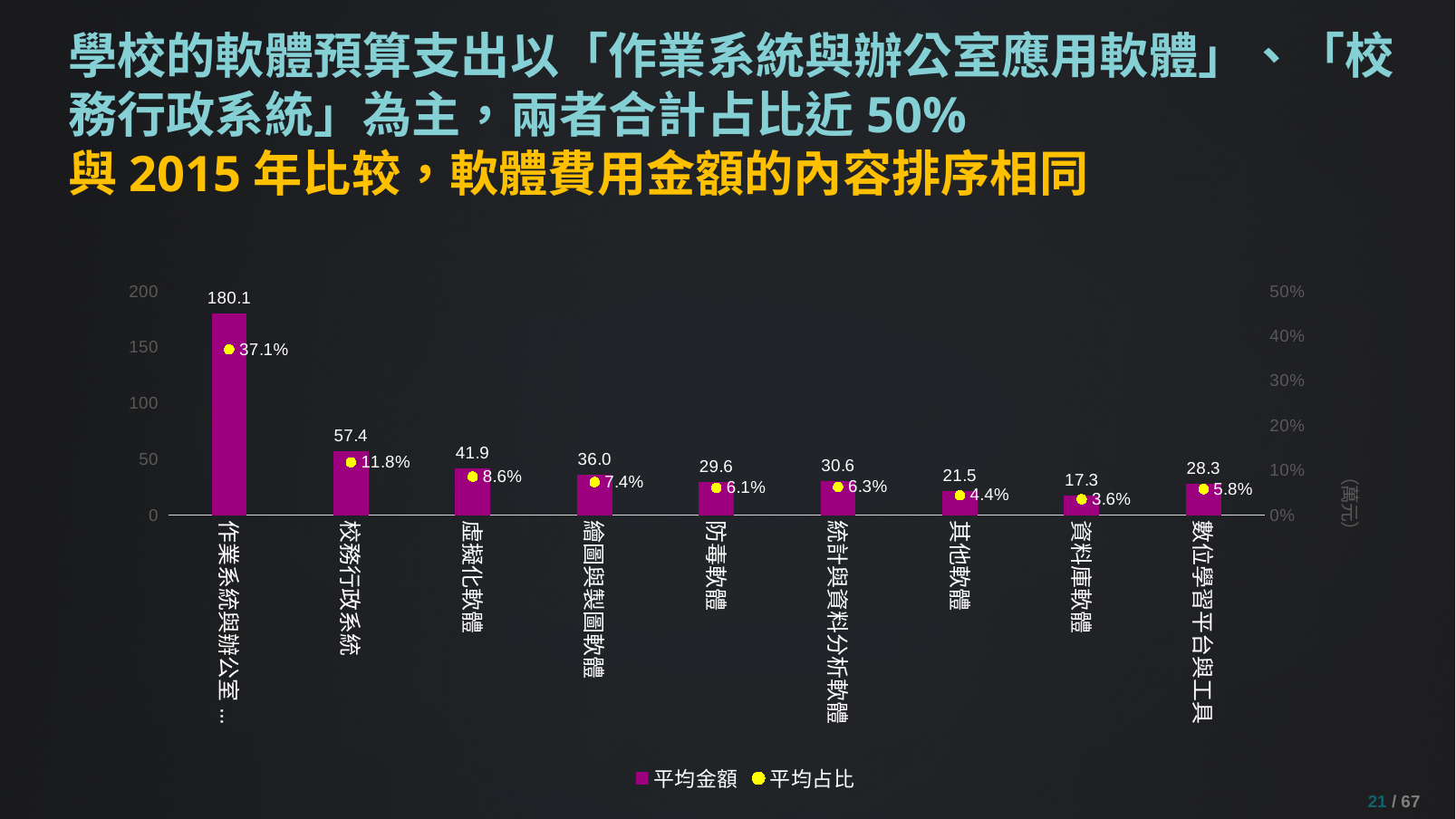
Is the 平均金額 for 繪圖與製圖軟體 greater or less than 50? less What is the 平均占比 value for 虛擬化軟體? 8.6% How many categories are shown on the x axis? 9 Which category has the lowest 平均占比? 資料庫軟體 What unit is shown on the right side of the chart? 萬元 Which category has the highest 平均金額? 作業系統與辦公室應用軟體 Which has a larger 平均金額, 防毒軟體 or 統計與資料分析軟體? 統計與資料分析軟體 What is the 平均金額 value for 數位學習平台與工具? 28.3 What is the difference in 平均金額 between 作業系統與辦公室應用軟體 and 校務行政系統? 122.7 How many series does the legend list? 2 What kind of chart is used to show 平均金額? bar chart What is the 平均金額 value for 校務行政系統? 57.4